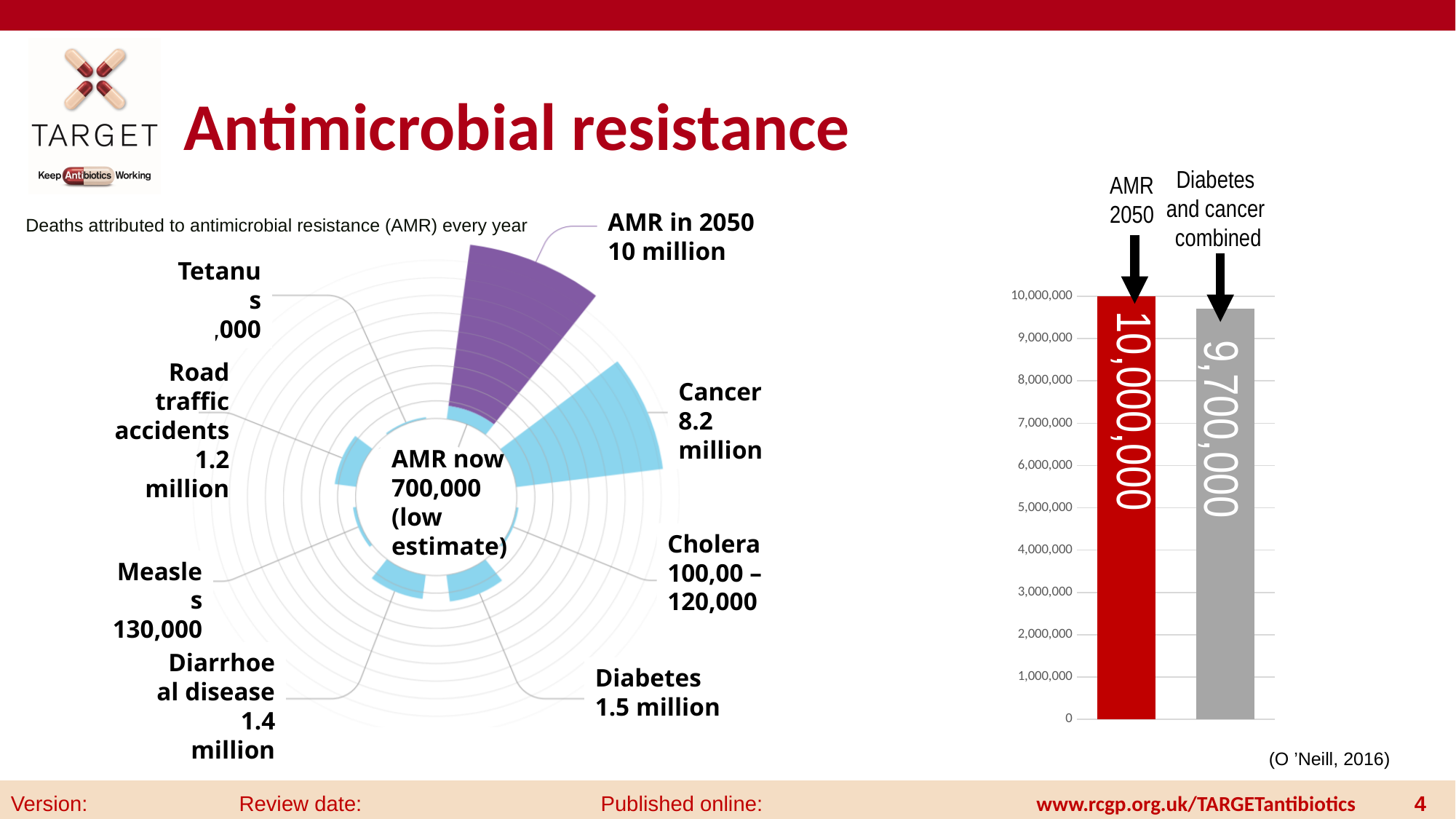
In the bar chart on the right, which bar is taller: AMR 2050 or Diabetes and cancer combined? AMR 2050 In the chart titled 'Deaths attributed to antimicrobial resistance (AMR) every year', how many deaths are attributed to cancer? 8.2 million What kind of chart is shown on the right side of the slide? Bar chart In the chart titled 'Deaths attributed to antimicrobial resistance (AMR) every year', what is the value given for AMR now (low estimate)? 700,000 In the bar chart on the right, what value is shown for Diabetes and cancer combined? 9,700,000 In the chart titled 'Deaths attributed to antimicrobial resistance (AMR) every year', how many deaths are attributed to diabetes? 1.5 million In the bar chart on the right, what value is shown for AMR 2050? 10,000,000 How many bars are plotted in the bar chart on the right? 2 In the chart titled 'Deaths attributed to antimicrobial resistance (AMR) every year', which is larger: deaths from road traffic accidents or deaths from measles? Road traffic accidents In the chart titled 'Deaths attributed to antimicrobial resistance (AMR) every year', which category has the largest value? AMR in 2050 In the bar chart on the right, what colour is the AMR 2050 bar? Red In the bar chart on the right, what is the difference between the AMR 2050 bar and the Diabetes and cancer combined bar? 300,000